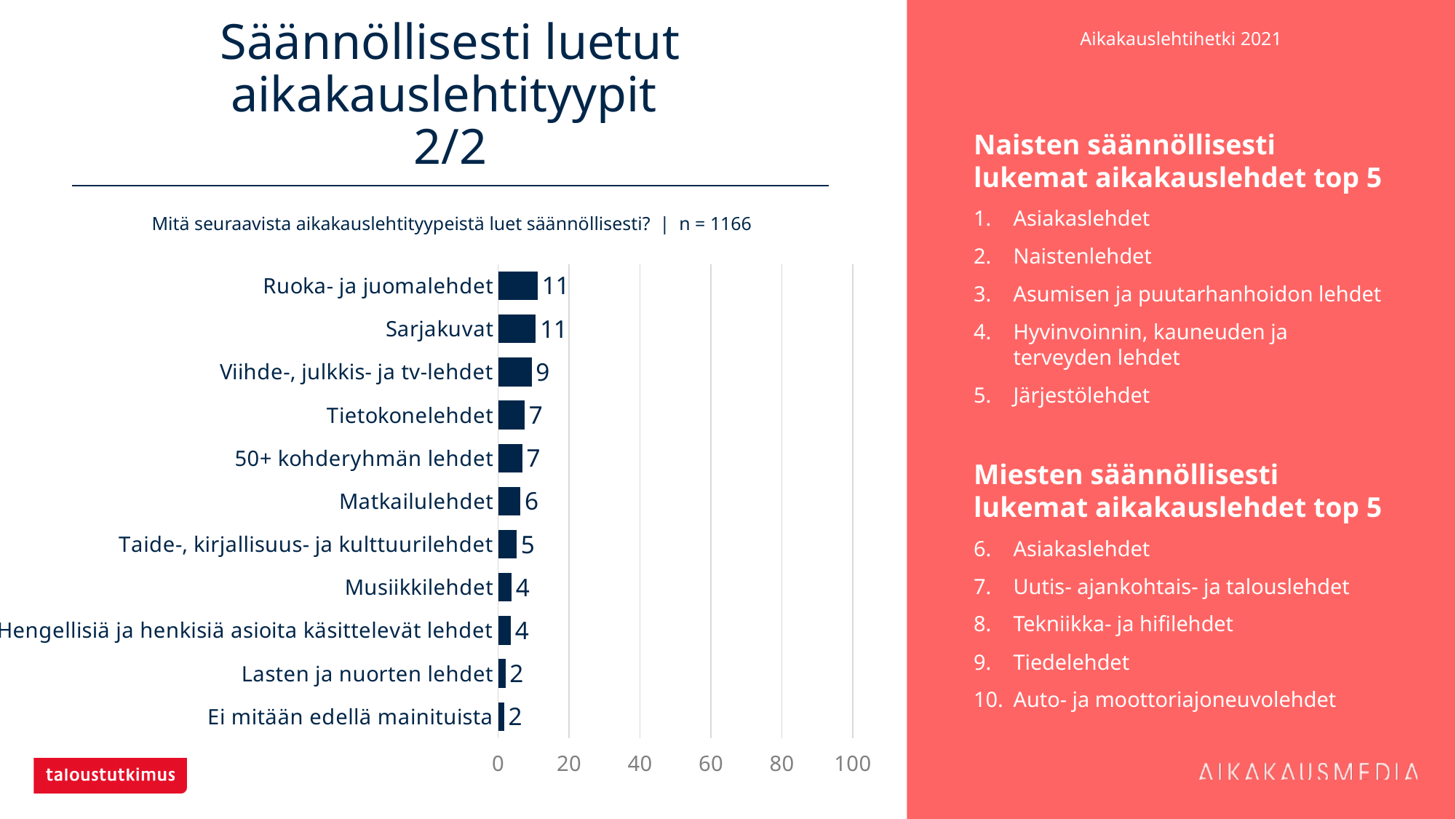
What is the highest value shown on the chart's axis? 100 What is the value for Matkailulehdet? 6 What is the value for Musiikkilehdet? 4 What is the value for Tietokonelehdet? 7 Which is larger, the value for Viihde-, julkkis- ja tv-lehdet or the value for 50+ kohderyhmän lehdet? Viihde-, julkkis- ja tv-lehdet What is the difference between the values for Ruoka- ja juomalehdet and Taide-, kirjallisuus- ja kulttuurilehdet? 6 What is the value for Sarjakuvat? 11 Is the value for Sarjakuvat greater or less than 20? less What kind of chart is shown on the slide? bar chart How many categories are shown in the chart? 11 What is the sample size (n) stated above the chart? 1166 What is the value for Viihde-, julkkis- ja tv-lehdet? 9